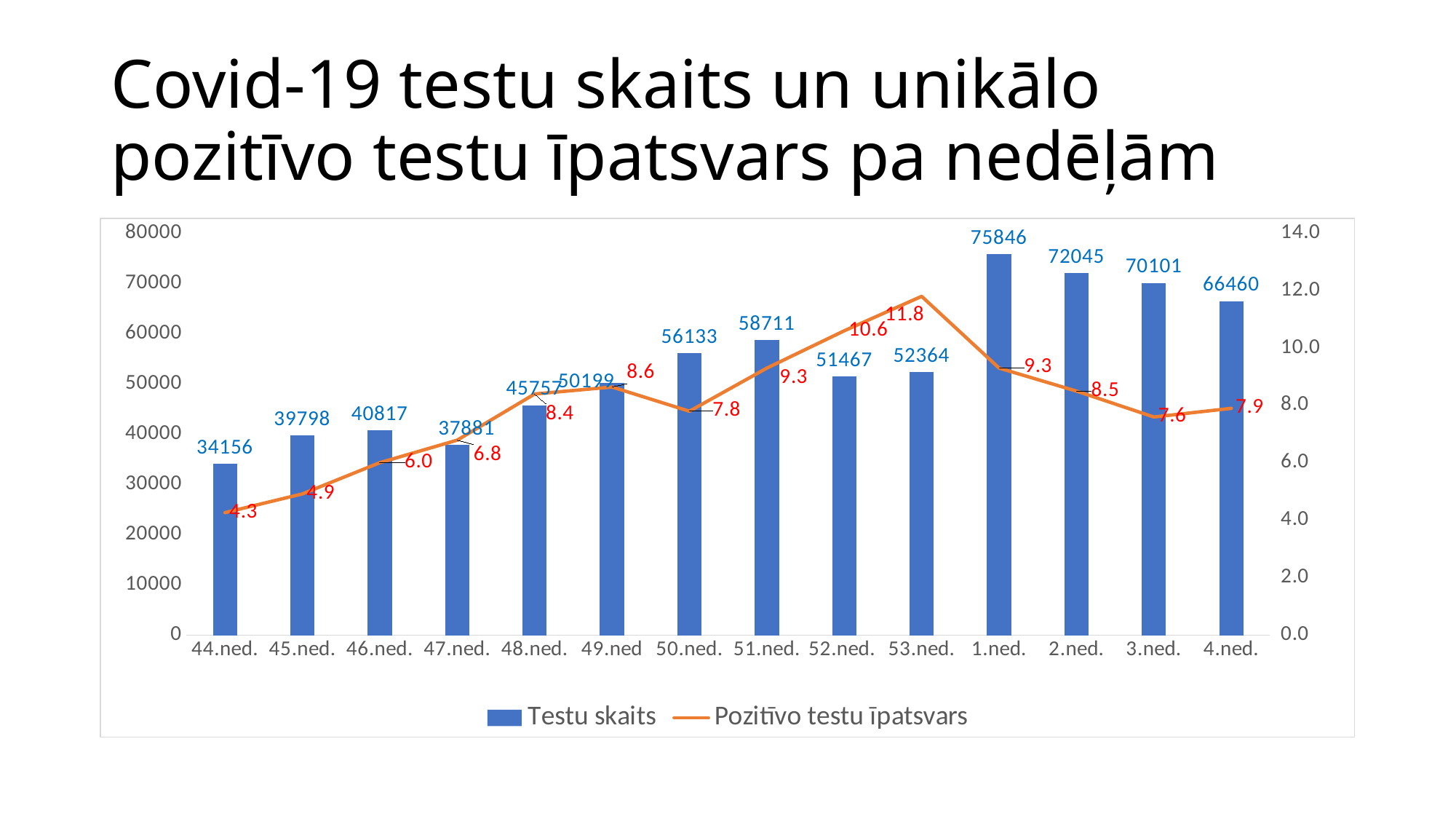
What is the difference in Testu skaits between 1.ned. and 2.ned.? 3801 Which week has the highest Testu skaits? 1.ned. What is the value of Testu skaits for 50.ned.? 56133 What colour are the Testu skaits bars? Blue How many series does the legend list? 2 How many weeks are shown on the x axis? 14 What is the value of Pozitīvo testu īpatsvars for 53.ned.? 11.8 Does Pozitīvo testu īpatsvars rise or fall from 53.ned. to 3.ned.? Fall Which is larger, the Testu skaits for 52.ned. or for 53.ned.? 53.ned. What kind of chart is used for the Testu skaits series? Bar chart What is the value of Testu skaits for 4.ned.? 66460 Which week has the lowest Pozitīvo testu īpatsvars? 44.ned.